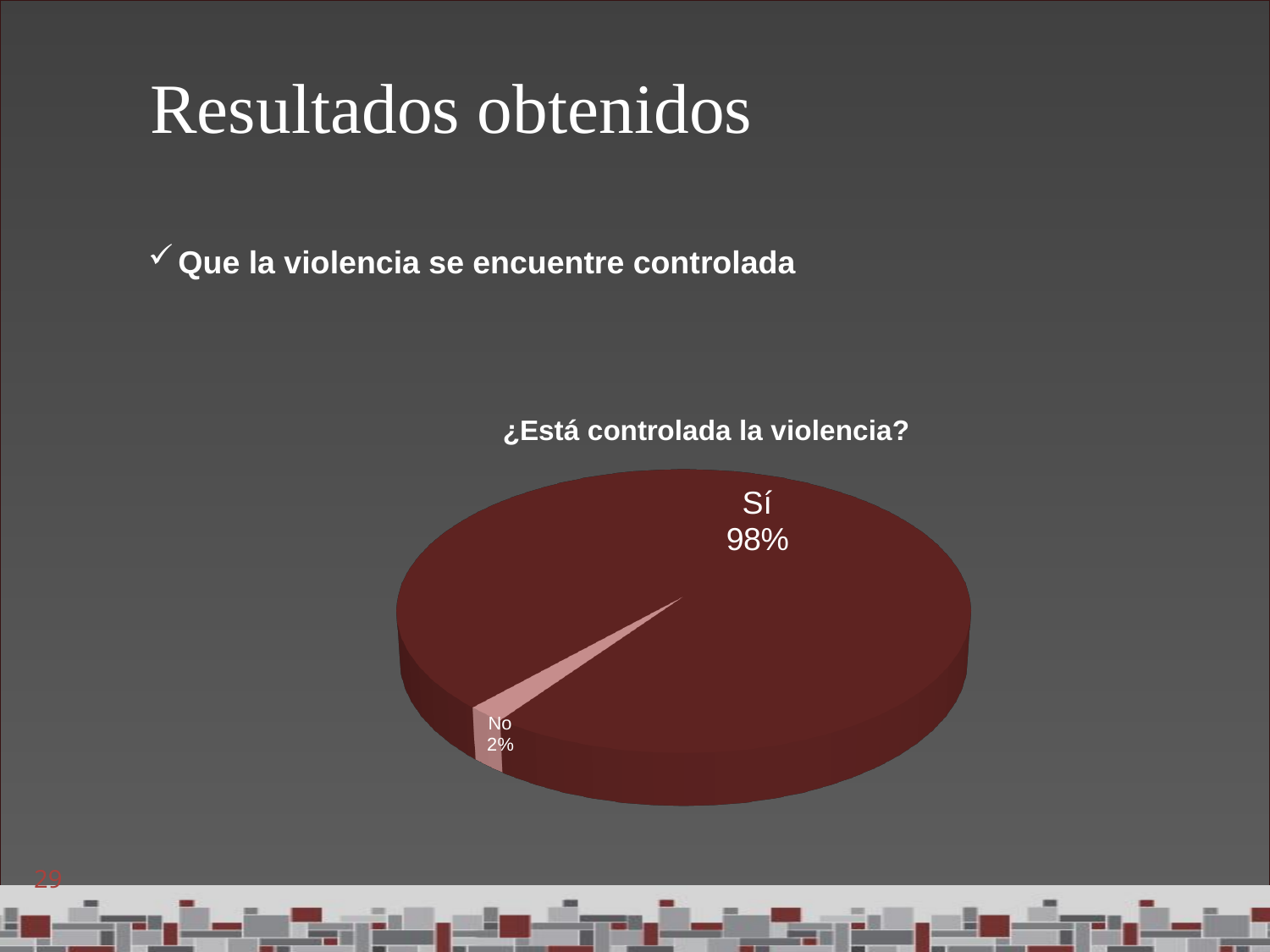
What type of chart is shown on the slide? Pie chart What colour is the "Sí" slice? Dark red Which slice is the smallest in the pie chart? No What is the difference in percentage points between the "Sí" and "No" slices? 96 Which is larger, the "Sí" slice or the "No" slice? Sí What percentage of the pie corresponds to "No"? 2% What share of the pie does the "No" slice represent? 2% Which slice is the largest in the pie chart? Sí What percentage of the pie corresponds to "Sí"? 98% What is the title of the chart? ¿Está controlada la violencia? How many slices does the pie chart have? 2